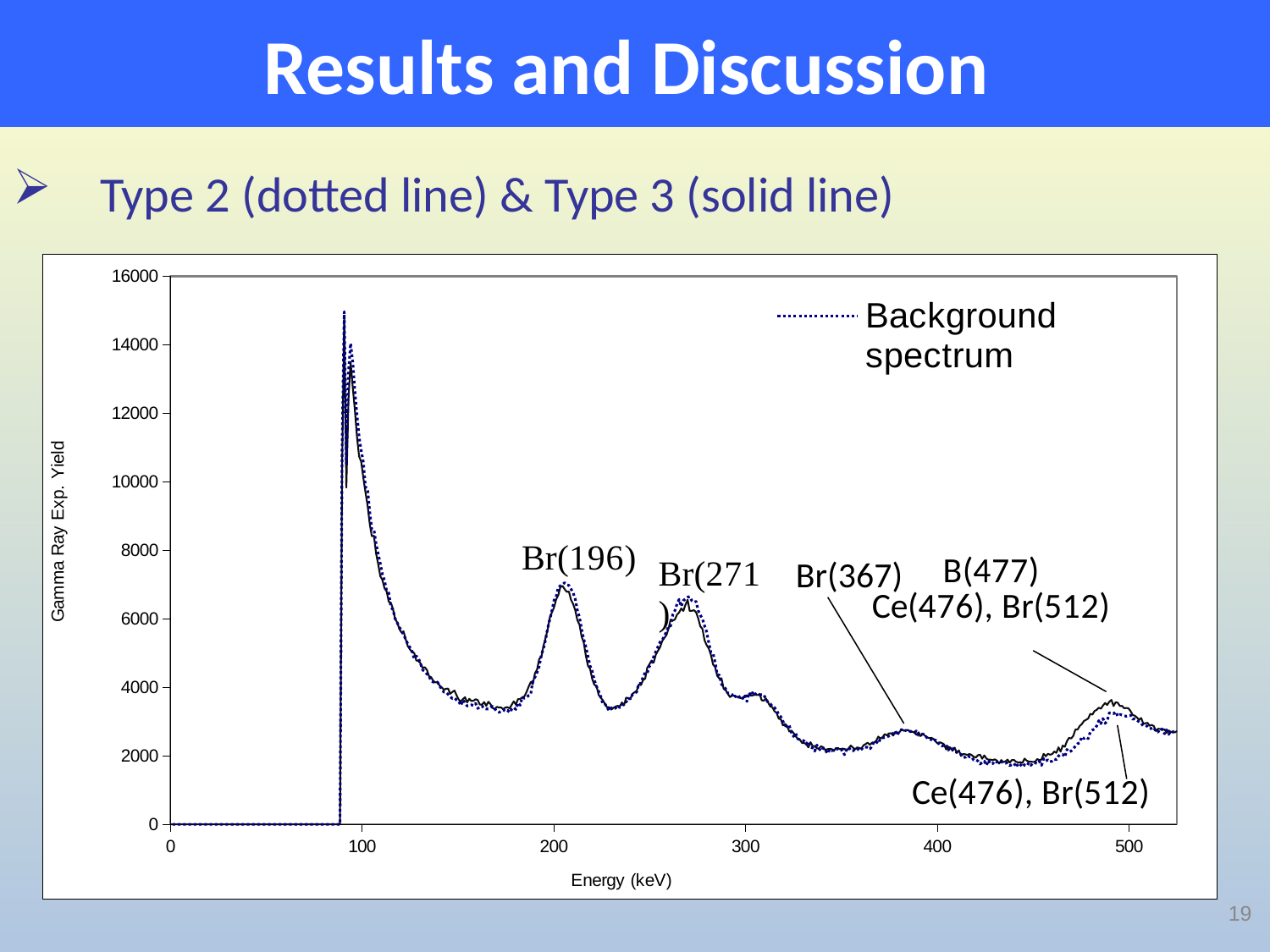
Is the value at the Br(271) peak greater or less than 8000? less Which peak is higher, Br(196) or Br(367)? Br(196) Is the value at the Br(367) peak greater or less than 4000? less Is the highest peak of the spectrum, just below 100 keV, greater or less than 14000? greater How many entries does the chart legend list? 1 Between 100 keV and 150 keV, do the plotted values rise or fall? fall What is the label of the y axis? Gamma Ray Exp. Yield What is the label of the x axis? Energy (keV) What kind of chart is shown on the slide? line chart